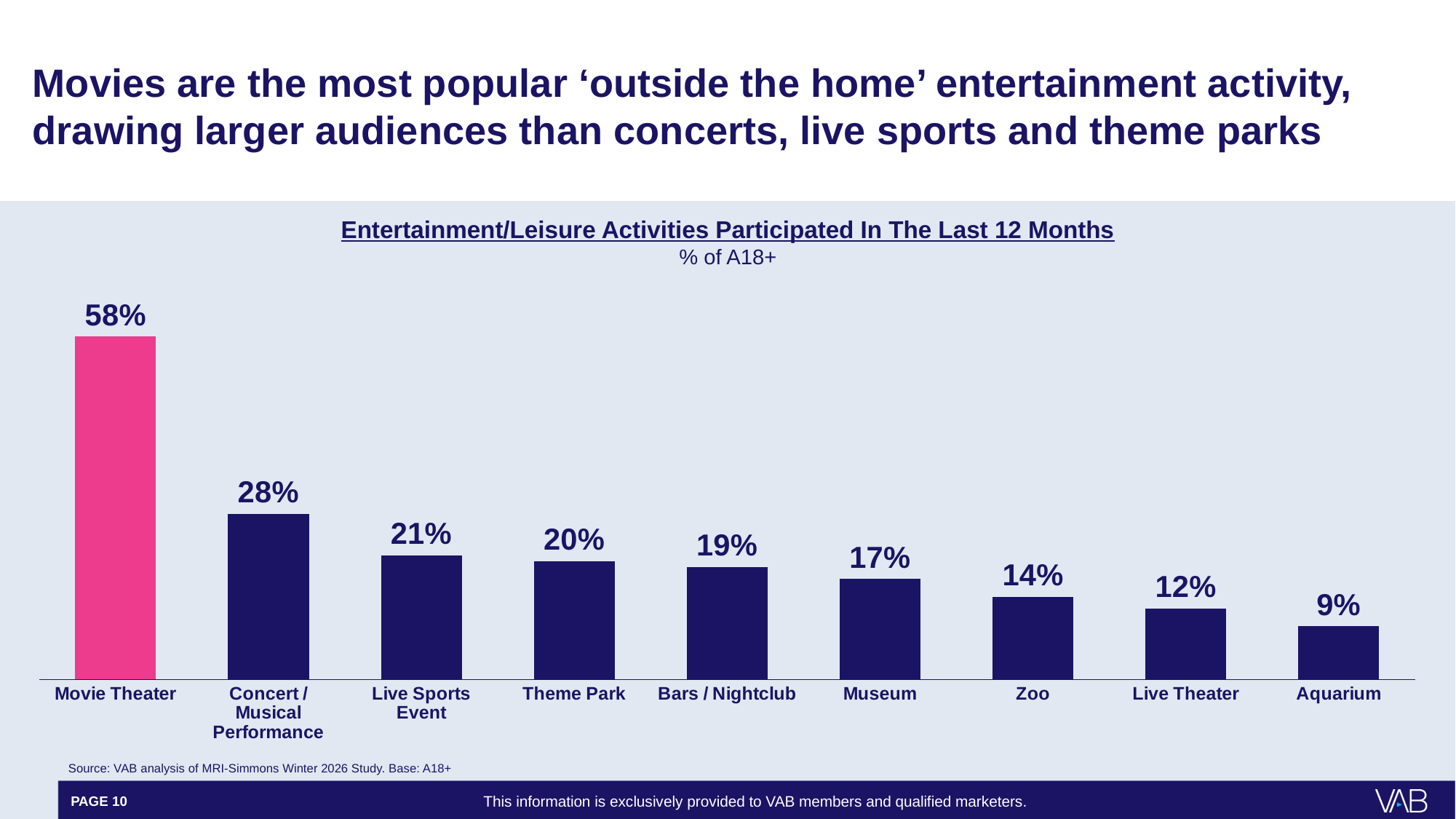
What percentage of A18+ participated in going to a Movie Theater in the last 12 months? 58% What is the difference between the Movie Theater value and the Concert / Musical Performance value? 30% What kind of chart is shown on the slide? Bar chart Which is larger, the value for Theme Park or the value for Zoo? Theme Park What is the value shown for Museum? 17% Which activity has the lowest participation percentage? Aquarium How many activities are shown in the chart? 9 Which activity has the highest participation percentage? Movie Theater What is the difference between the Live Sports Event value and the Live Theater value? 9% What is the value shown for Zoo? 14% Do the values rise or fall moving from left to right across the chart? Fall Which bar is highlighted in a different colour (pink) from the others? Movie Theater